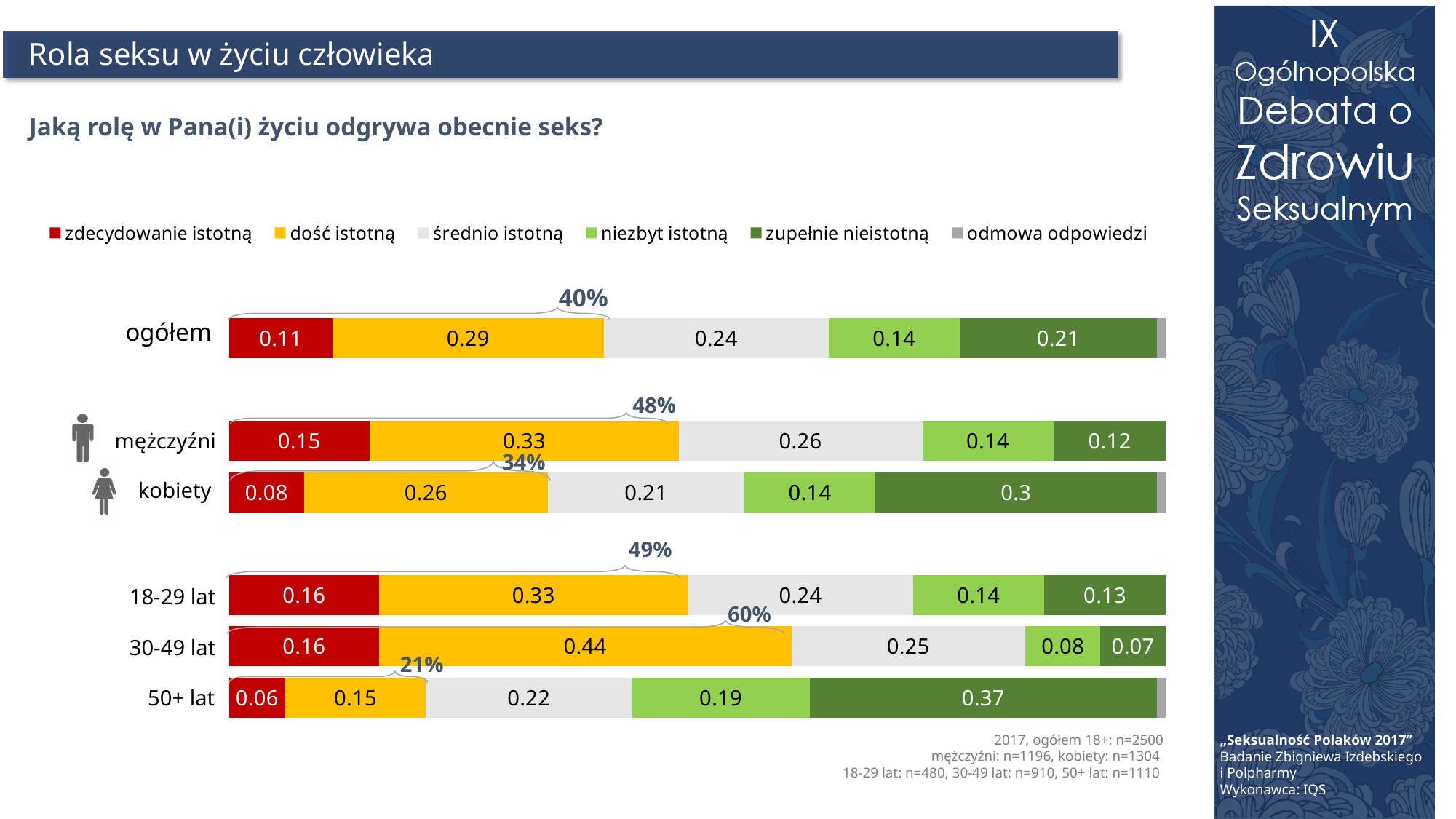
Which is larger: the 'średnio istotną' value for mężczyźni or for kobiety? mężczyźni What type of chart is shown on the slide? stacked bar chart What is the value of 'zdecydowanie istotną' for kobiety? 0.08 What combined percentage is shown above the bar for 30-49 lat? 60% How many categories (bars) are plotted in the chart? 6 What is the value of 'zupełnie nieistotną' for the 50+ lat group? 0.37 Which category has the highest value for 'zupełnie nieistotną'? 50+ lat What is the difference between the 'dość istotną' values for mężczyźni and kobiety? 0.07 What is the value of 'dość istotną' for the 30-49 lat group? 0.44 How many series does the legend list? 6 Which category has the lowest value for 'zdecydowanie istotną'? 50+ lat Which legend entry is shown in red? zdecydowanie istotną